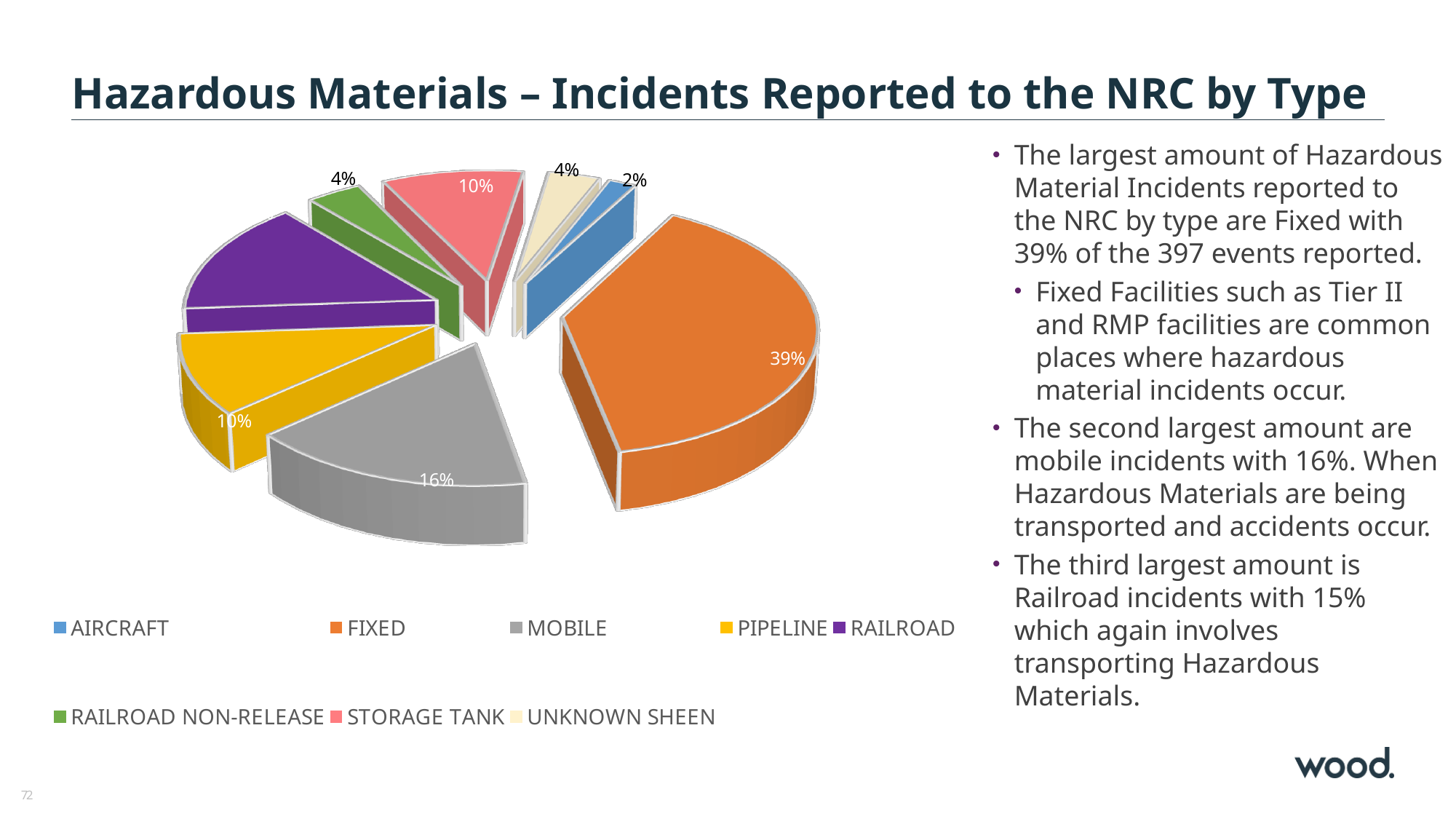
What percentage is shown for the STORAGE TANK slice? 10% What percentage is shown for the AIRCRAFT slice? 2% Which incident type has the smallest slice of the pie? AIRCRAFT What share of incidents does the FIXED slice represent? 39% What percentage is shown for the RAILROAD NON-RELEASE slice? 4% What percentage is shown for the UNKNOWN SHEEN slice? 4% How many incident types does the legend list? 8 What percentage is shown for the MOBILE slice? 16% How many percentage points larger is the FIXED slice than the MOBILE slice? 23 What kind of chart is shown on the slide? Pie chart Which slice is larger, MOBILE or PIPELINE? MOBILE Which incident type has the largest slice of the pie? FIXED